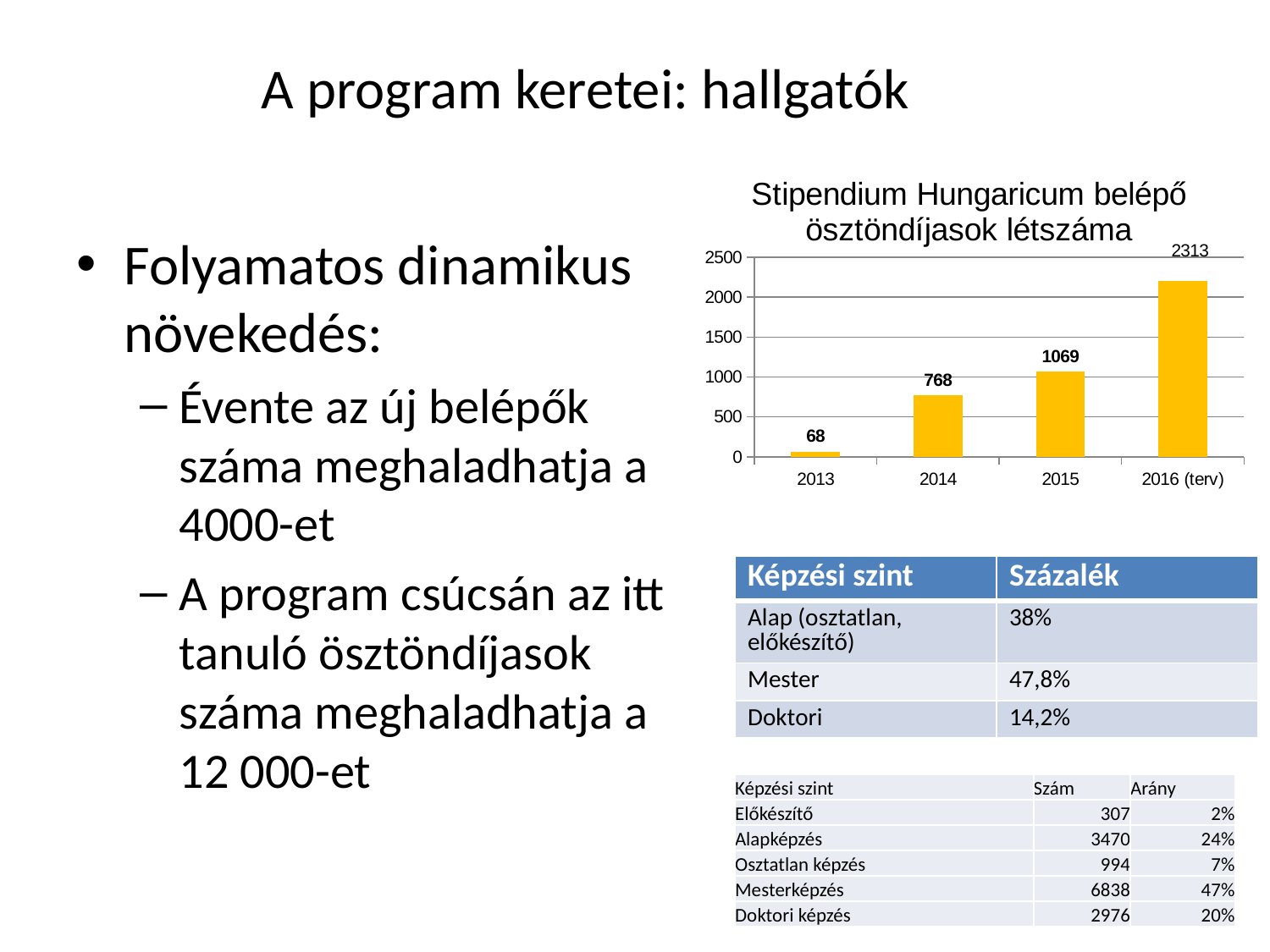
What is the value for 2016 (terv) in the chart? 2313 How many categories are shown on the x axis of the chart? 4 What is the value for 2013 in the chart? 68 What is the value for 2014 in the chart? 768 What is the value for 2015 in the chart? 1069 Which is larger, the value for 2014 or the value for 2015? 2015 Which category has the highest value in the chart? 2016 (terv) What is the difference between the values for 2015 and 2014? 301 Which category has the lowest value in the chart? 2013 Is the value for 2015 greater or less than 1000? greater What kind of chart is shown on the slide? bar chart Do the values rise or fall from 2013 to 2016 (terv)? rise